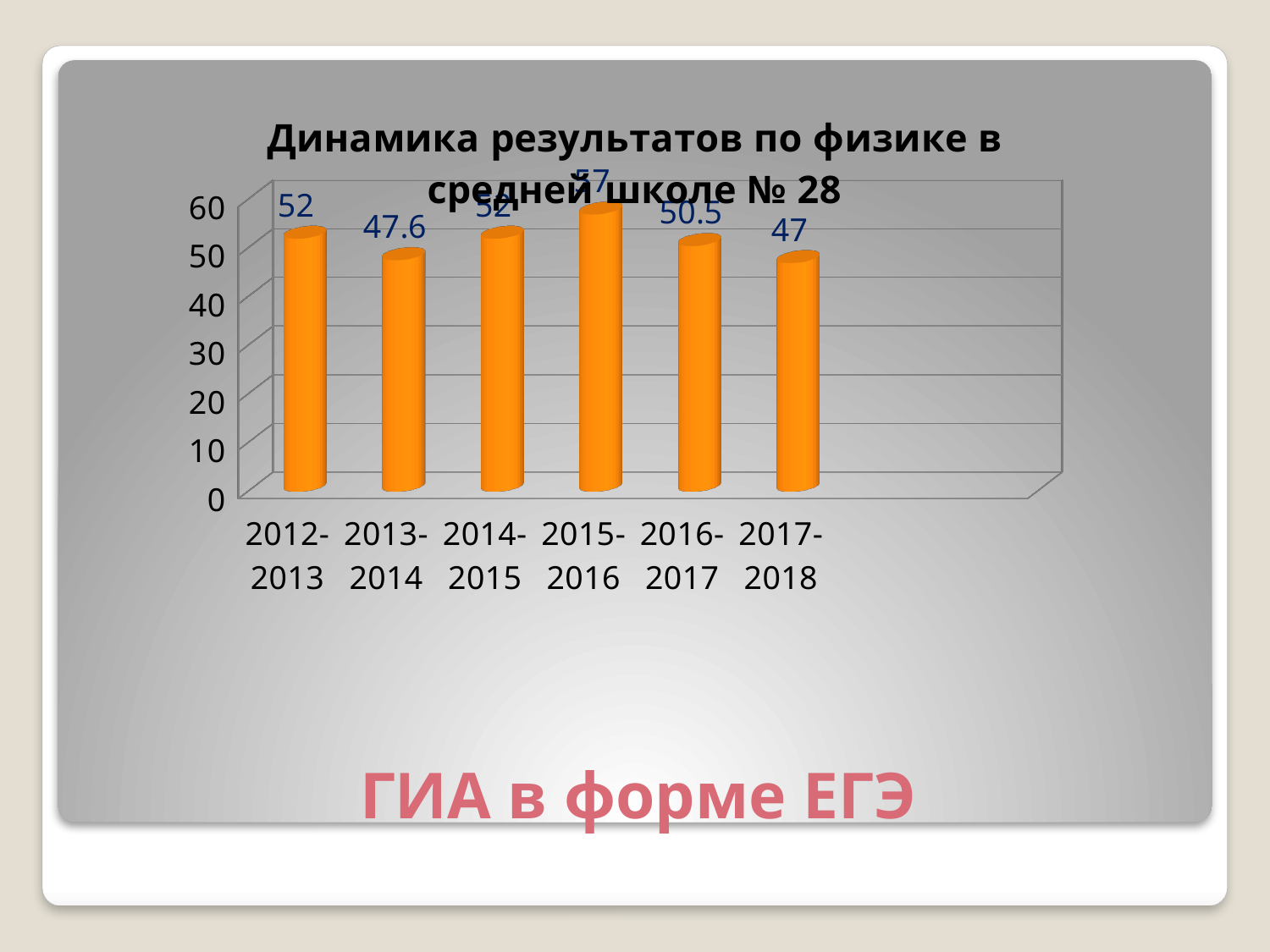
Which school year has the highest value? 2015-2016 Which school year has the lowest value? 2017-2018 What is the value for 2013-2014? 47.6 Which is larger, the value for 2016-2017 or the value for 2013-2014? 2016-2017 What is the difference between the values for 2014-2015 and 2013-2014? 4.4 Did the value rise or fall from 2015-2016 to 2016-2017? fall What is the difference between the values for 2015-2016 and 2017-2018? 10 What is the value for 2015-2016? 57 How many school years are shown on the x axis? 6 What is the value for 2012-2013? 52 What is the value for 2016-2017? 50.5 What kind of chart is shown on the slide? bar chart